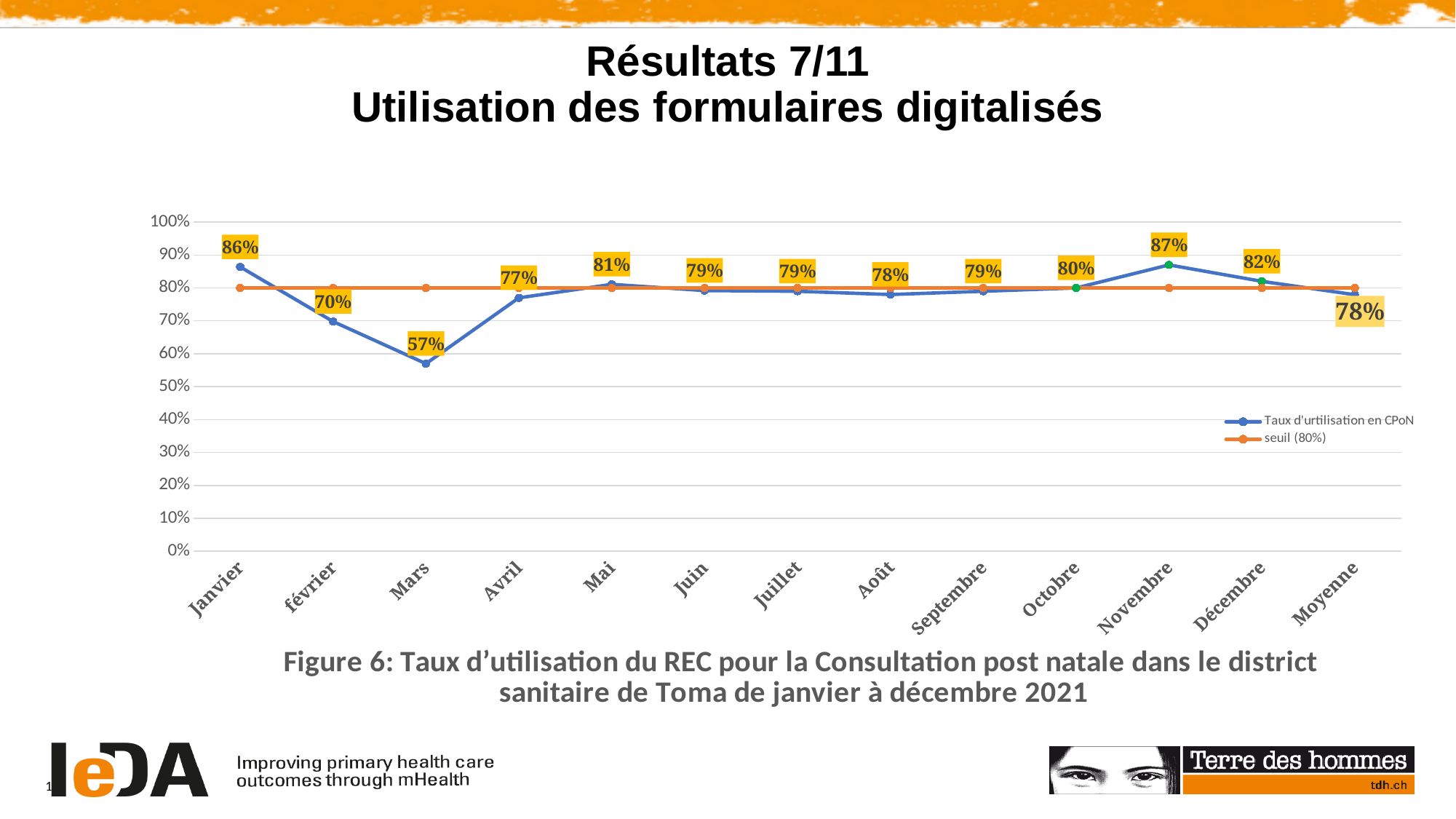
What is the value shown for Moyenne? 78% What is the value for Mars in the 'Taux d'urtilisation en CPoN' series? 57% What is the value for Novembre in the 'Taux d'urtilisation en CPoN' series? 87% Is the value for Mars greater or less than 60%? less Which month has the highest 'Taux d'urtilisation en CPoN' value? Novembre Which month has the lowest 'Taux d'urtilisation en CPoN' value? Mars What is the difference between the Janvier value and the février value? 16% How many series does the legend list? 2 What kind of chart is shown on the slide? line chart How many categories are shown on the x axis? 13 Which is larger, the value for Avril or the value for Mai? Mai What value does the 'seuil (80%)' series hold across all months? 80%